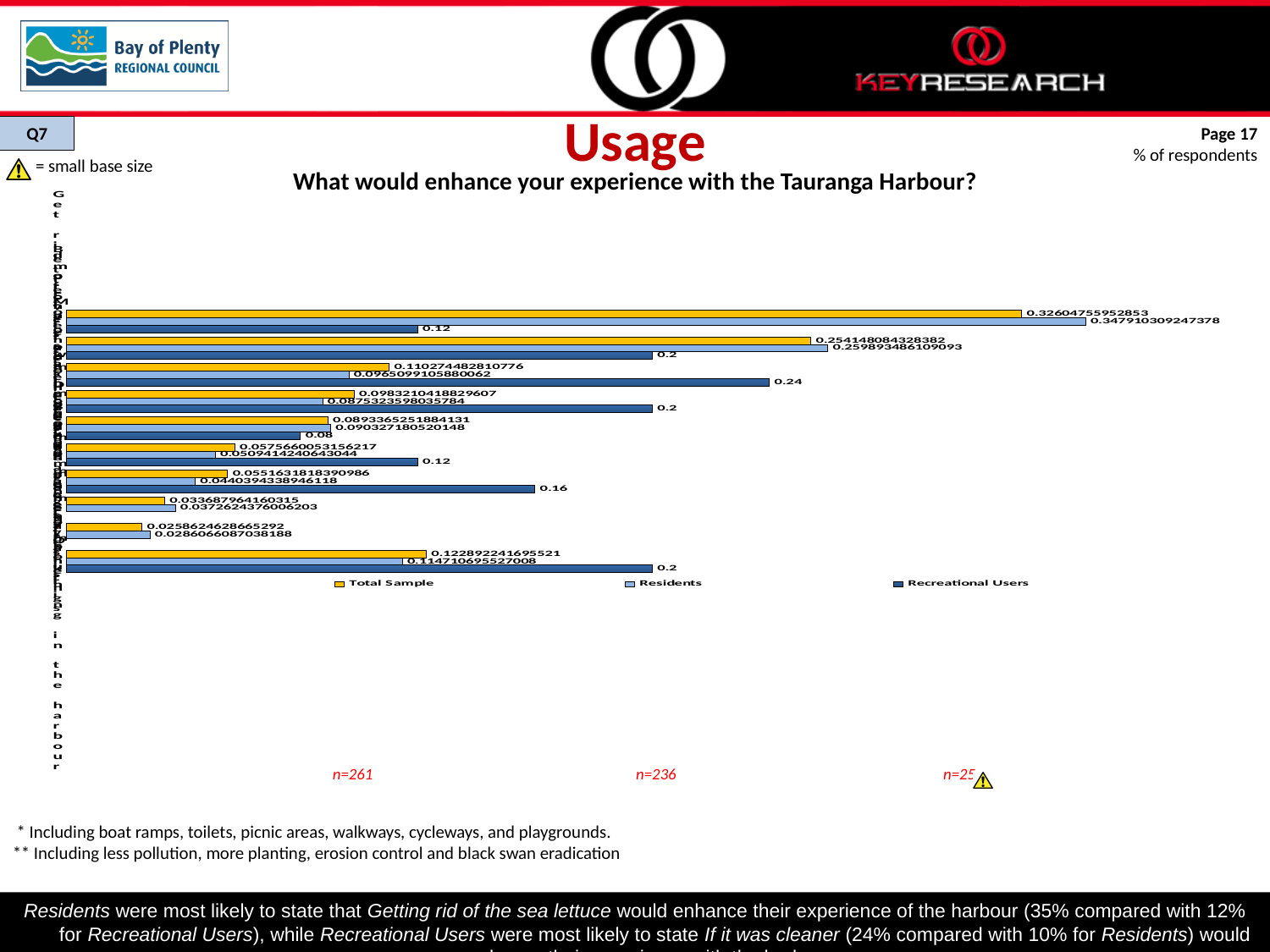
What is the title of the chart? What would enhance your experience with the Tauranga Harbour? What is the lowest value shown for the Recreational Users series? 0.08 How many category groups of bars are plotted in the chart? 10 What is the lowest value shown for the Total Sample series? 0.0258624628665292 What is the highest value shown for the Recreational Users series? 0.24 What are the three series named in the chart's legend? Total Sample, Residents, Recreational Users In the top group of bars, what is the value for Recreational Users? 0.12 How many series does the chart's legend list? 3 What is the highest value shown for the Residents series? 0.347910309247378 In the top group of bars, which series has the larger value: Residents or Recreational Users? Residents What kind of chart is shown on the slide? bar chart What is the highest value shown for the Total Sample series? 0.32604755952853